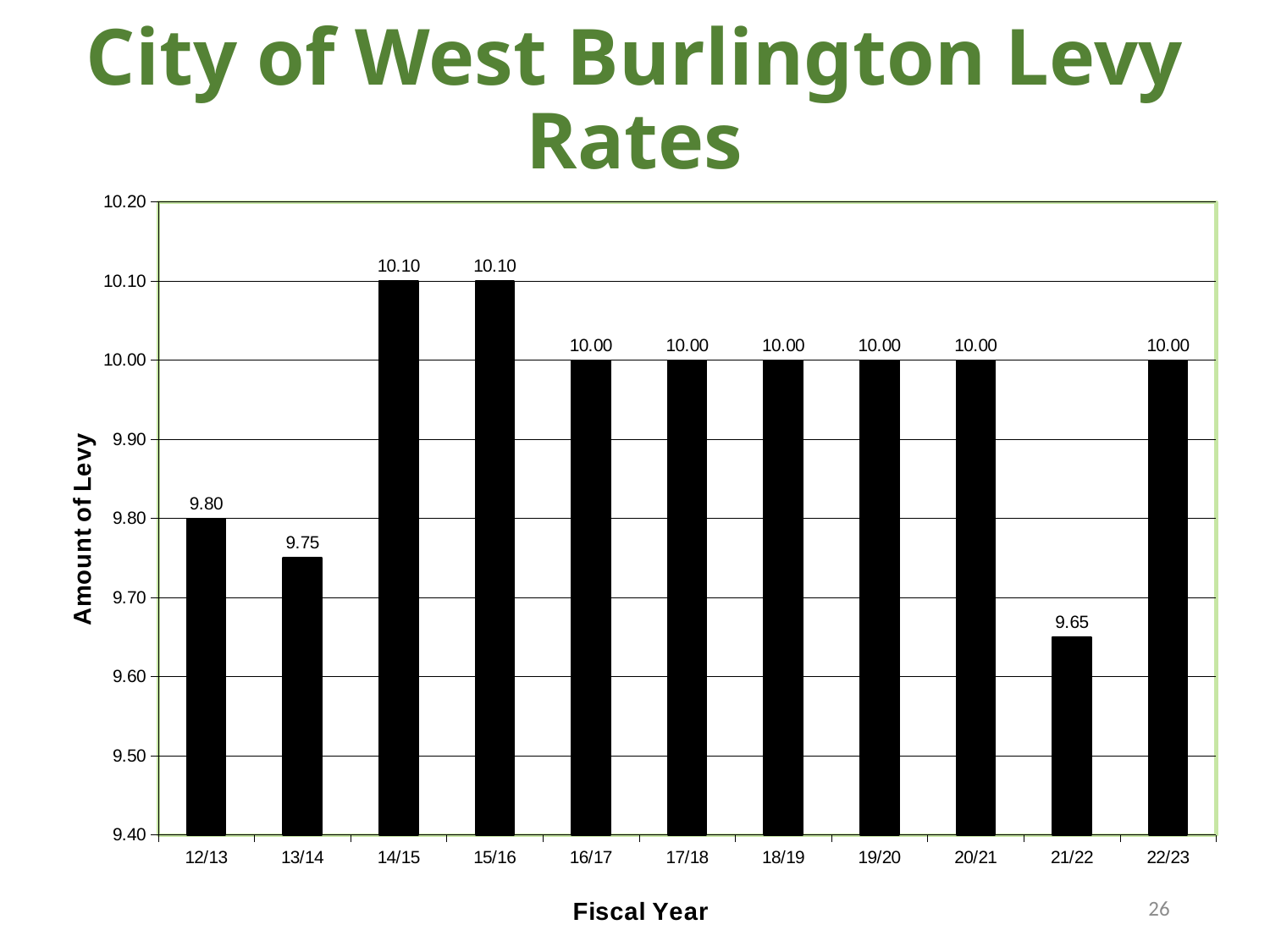
How many fiscal years are shown on the chart? 11 What is the label on the vertical axis? Amount of Levy What is the title of the chart? City of West Burlington Levy Rates What kind of chart is shown on the slide? bar chart Is the levy rate for 15/16 greater or less than 10.00? greater What is the levy rate for fiscal year 21/22? 9.65 What is the difference between the levy rate in 22/23 and the levy rate in 21/22? 0.35 Which is larger, the levy rate for 12/13 or the levy rate for 13/14? 12/13 What is the levy rate for fiscal year 12/13? 9.80 What is the difference between the levy rate in 14/15 and the levy rate in 13/14? 0.35 What is the levy rate for fiscal year 13/14? 9.75 Which fiscal year has the lowest levy rate? 21/22